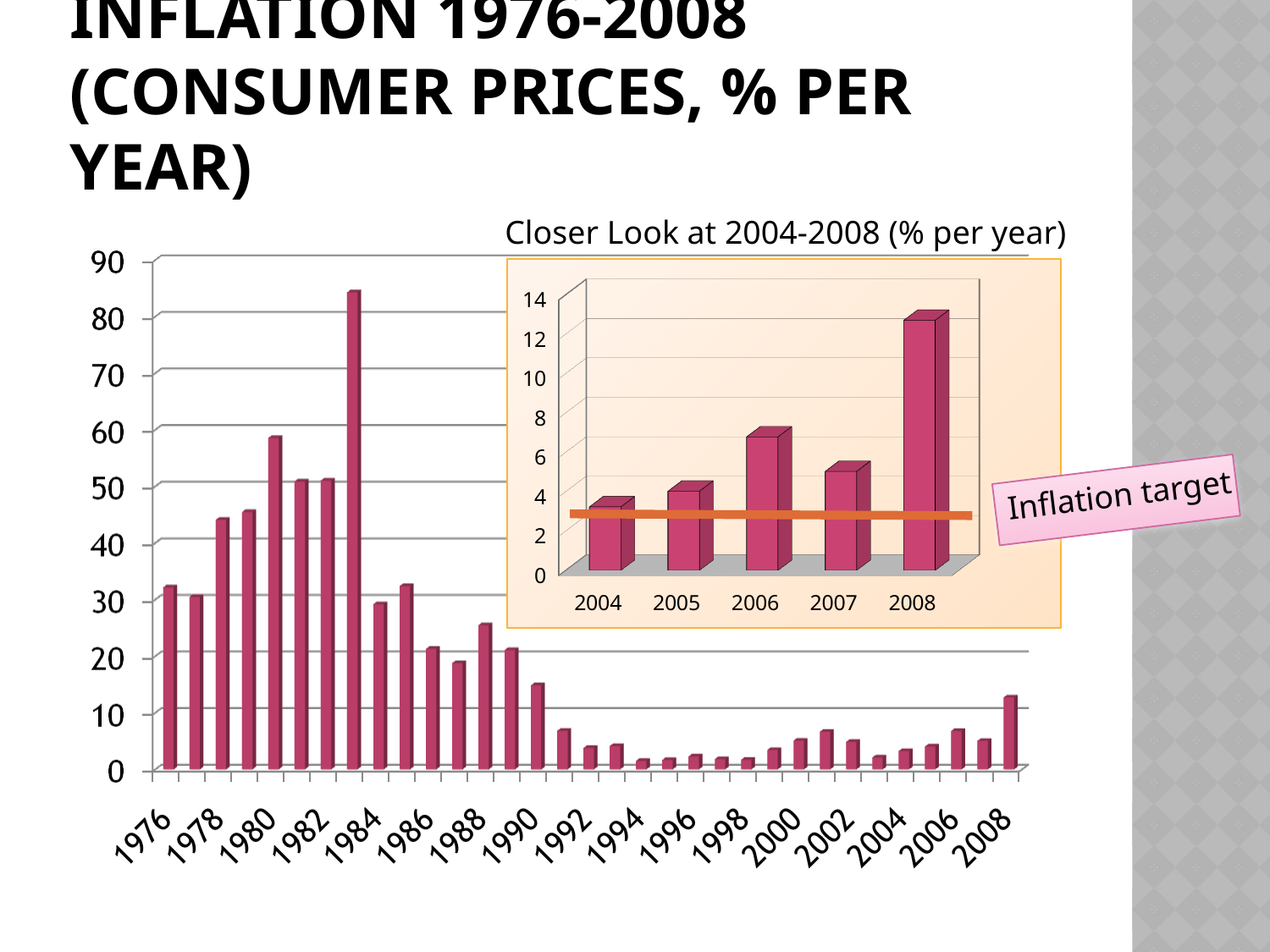
In the inset chart 'Closer Look at 2004-2008', which is larger, the value for 2006 or the value for 2007? 2006 In the inset chart 'Closer Look at 2004-2008', what does the horizontal orange line represent? Inflation target In the inset chart 'Closer Look at 2004-2008', which year has the lowest value? 2004 In the main chart 'Inflation 1976-2008', is the value for 1991 greater or less than 10? less In the inset chart 'Closer Look at 2004-2008', which year has the highest value? 2008 In the main chart 'Inflation 1976-2008', which year has the highest inflation? 1983 In the main chart 'Inflation 1976-2008', is the value for 1983 greater or less than 80? greater In the inset chart 'Closer Look at 2004-2008', how many years are plotted? 5 What kind of chart is the main chart titled 'Inflation 1976-2008 (Consumer Prices, % per year)'? bar chart In the main chart 'Inflation 1976-2008', is the value for 1980 greater or less than 50? greater In the main chart 'Inflation 1976-2008', which is larger, the value for 1980 or the value for 1983? 1983